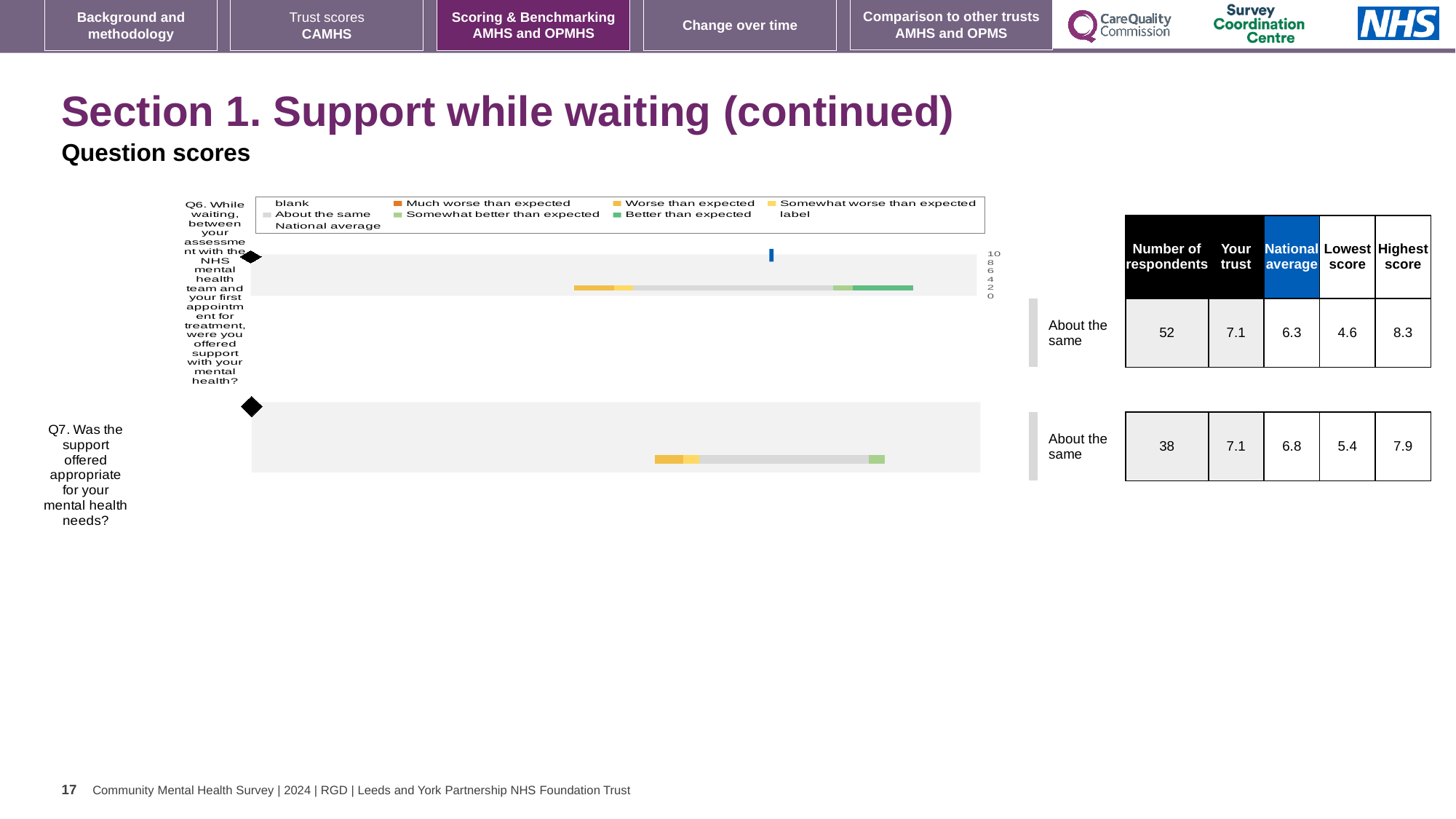
What is the 'Your trust' score for Q6 (support while waiting)? 7.1 How many questions (categories) are plotted in the chart? 2 How many respondents answered Q6? 52 What is the difference between the trust score and the national average for Q6? 0.8 How many respondents answered Q7? 38 Which question has the higher national average, Q6 or Q7? Q7 What is the national average score for Q7 (was the support offered appropriate)? 6.8 Which colour does the legend use for 'Much worse than expected'? orange What is the highest score shown for Q6? 8.3 What benchmark category is the trust placed in for Q7? About the same What is the lowest score shown for Q7? 5.4 What kind of chart is used to show the question scores on this slide? bar chart